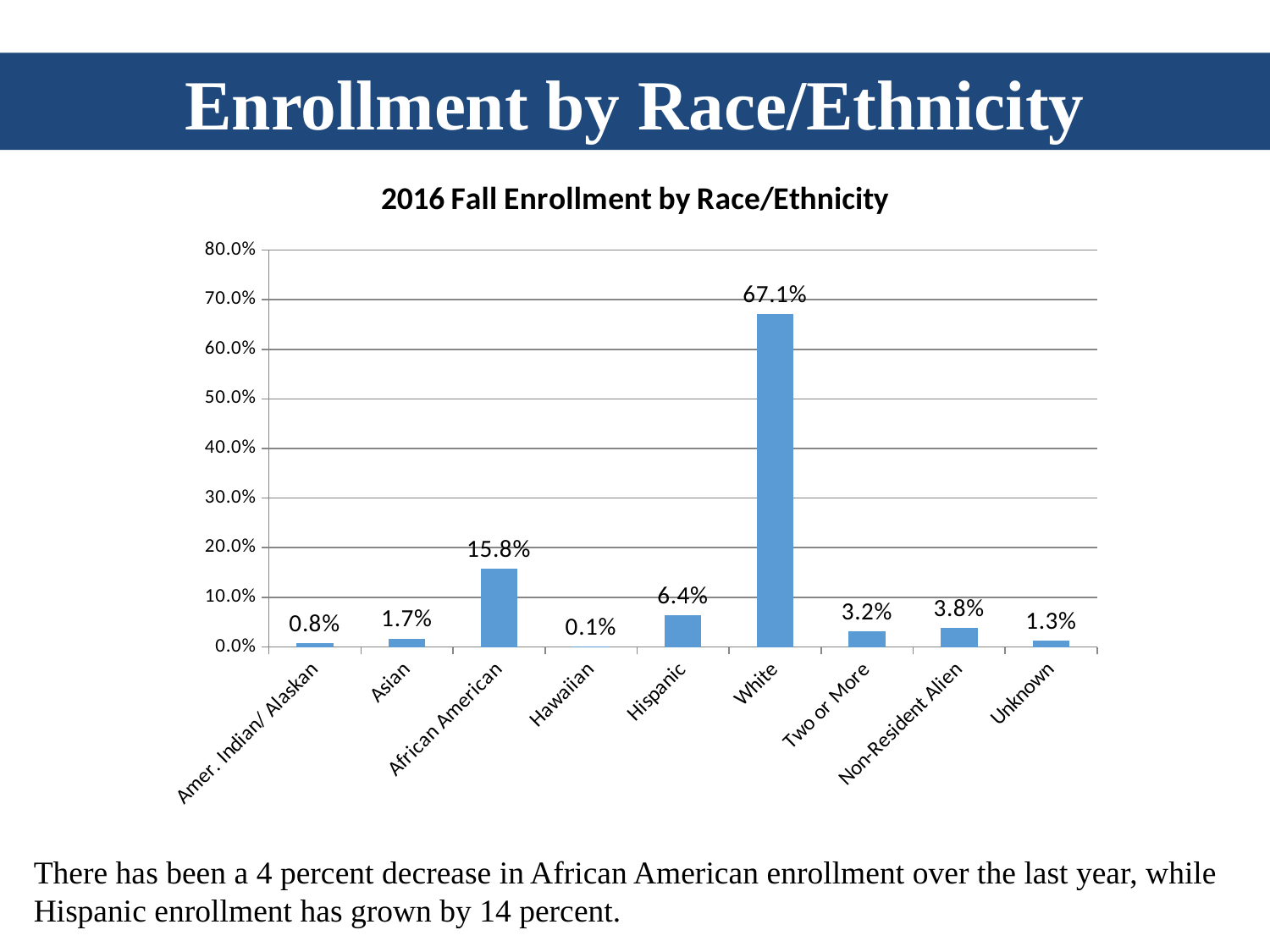
What is the title of the chart? 2016 Fall Enrollment by Race/Ethnicity What is the enrollment percentage for Non-Resident Alien? 3.8% Which is larger, the enrollment percentage for Two or More or for Non-Resident Alien? Non-Resident Alien How many race/ethnicity categories are shown on the chart? 9 What is the difference between the White and African American enrollment percentages? 51.3% Which race/ethnicity category has the lowest enrollment percentage? Hawaiian Which race/ethnicity category has the highest enrollment percentage? White What kind of chart is shown on the slide? Bar chart What is the enrollment percentage for White? 67.1% Is the value for African American greater or less than 10.0%? greater What is the enrollment percentage for Hispanic? 6.4% What is the enrollment percentage for African American? 15.8%